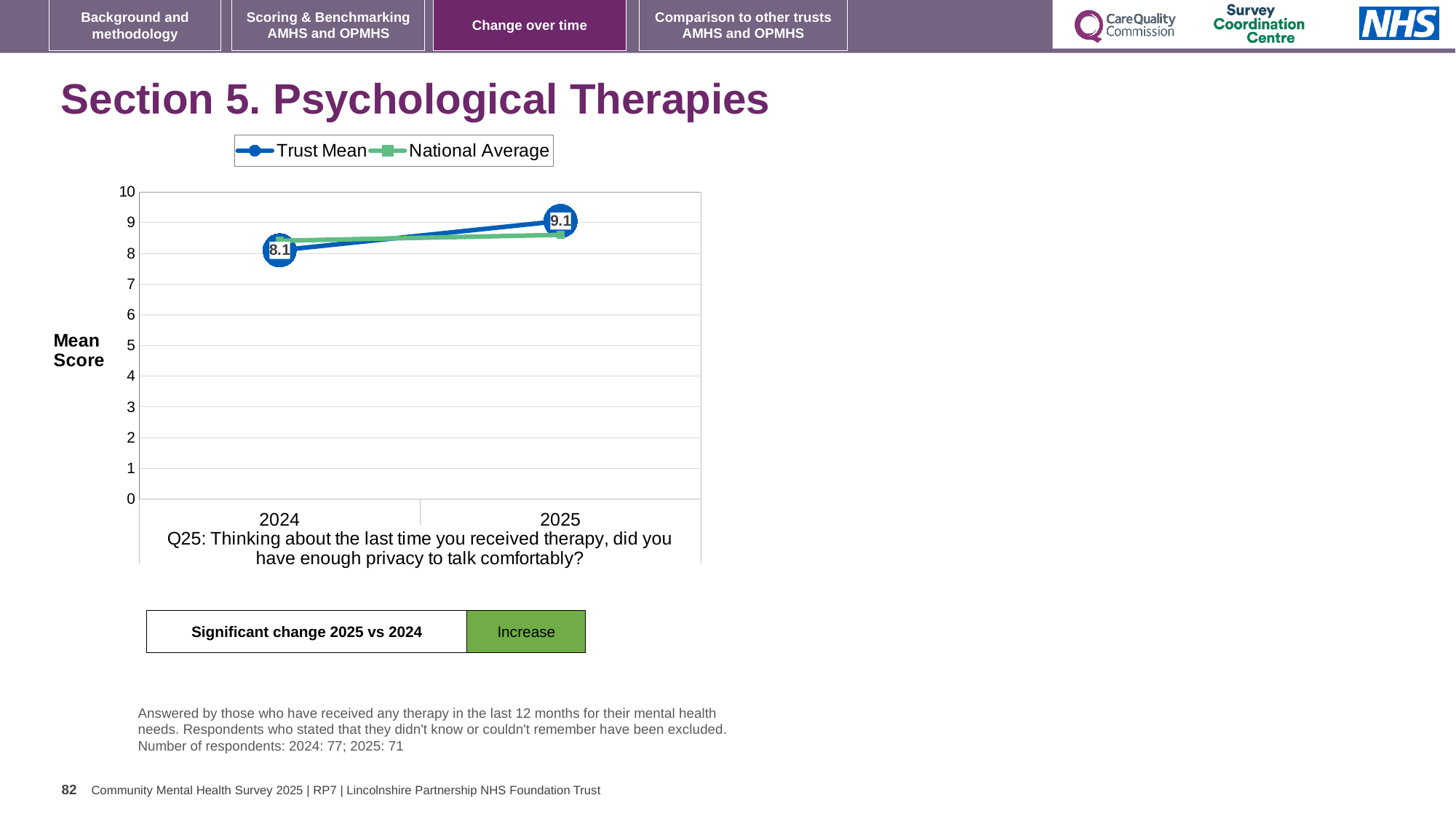
How many years are plotted on the x axis? 2 What is the label on the y axis of the chart? Mean Score How many series does the legend list? 2 Is the National Average for 2024 greater or less than 8? greater What is the Trust Mean score for 2024? 8.1 What type of chart is shown on the slide? Line chart What is the Trust Mean score for 2025? 9.1 Is the National Average for 2025 greater or less than 9? less Does the Trust Mean rise or fall from 2024 to 2025? Rise Which year has the higher Trust Mean score, 2024 or 2025? 2025 In 2025, which is higher: the Trust Mean or the National Average? Trust Mean By how much did the Trust Mean change from 2024 to 2025? 1.0